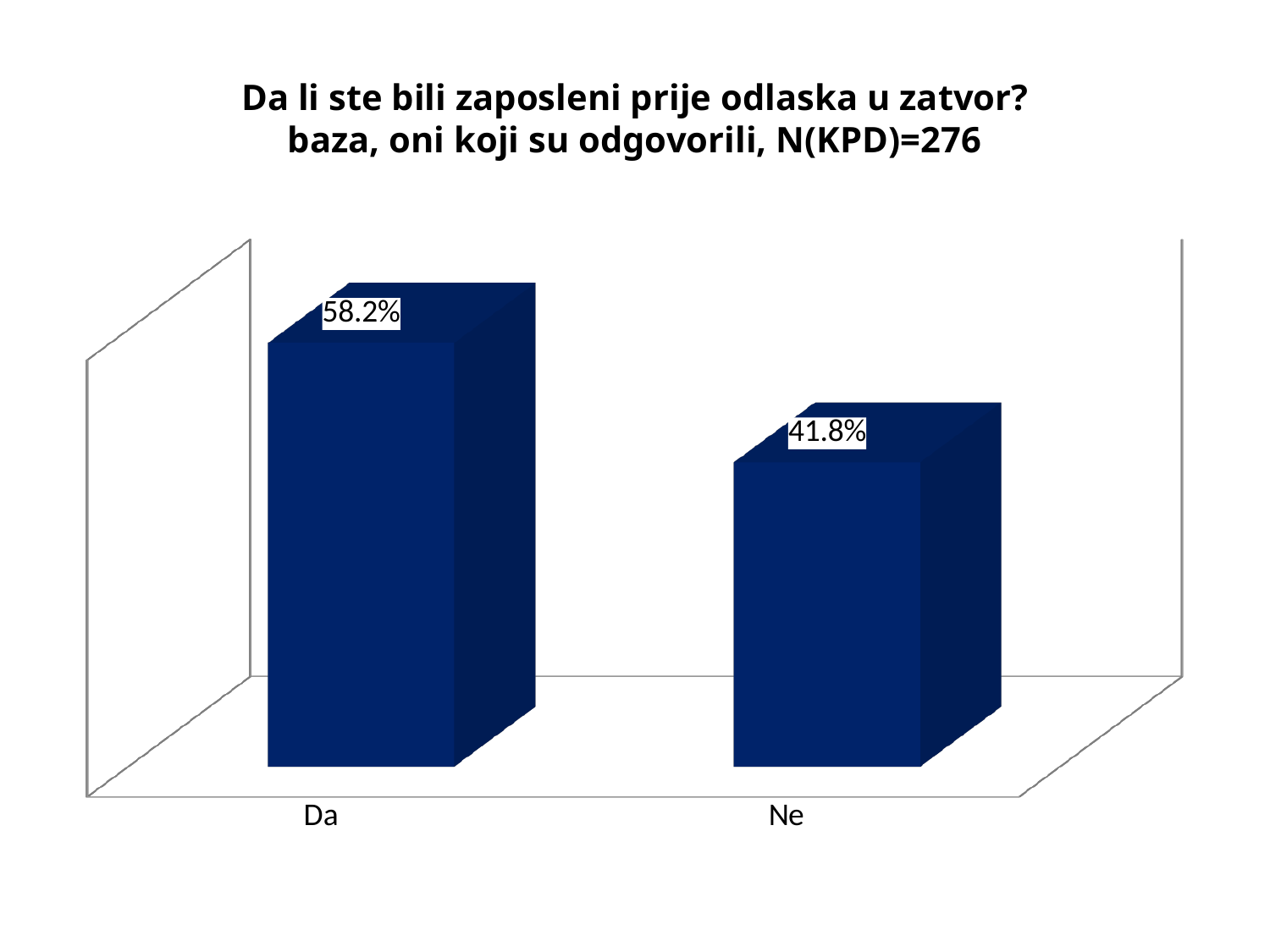
What is the total of the two values shown on the chart? 100% What kind of chart is shown on the slide? Bar chart What is the value for "Ne"? 41.8% Which category has the highest value? Da Which is larger, the value for "Da" or the value for "Ne"? Da How many categories are shown on the chart? 2 Which category has the lowest value? Ne What is the value for "Da"? 58.2% What is the difference between the values for "Da" and "Ne"? 16.4% What is the base size (N) stated in the chart title? 276 What colour are the bars in the chart? Dark blue